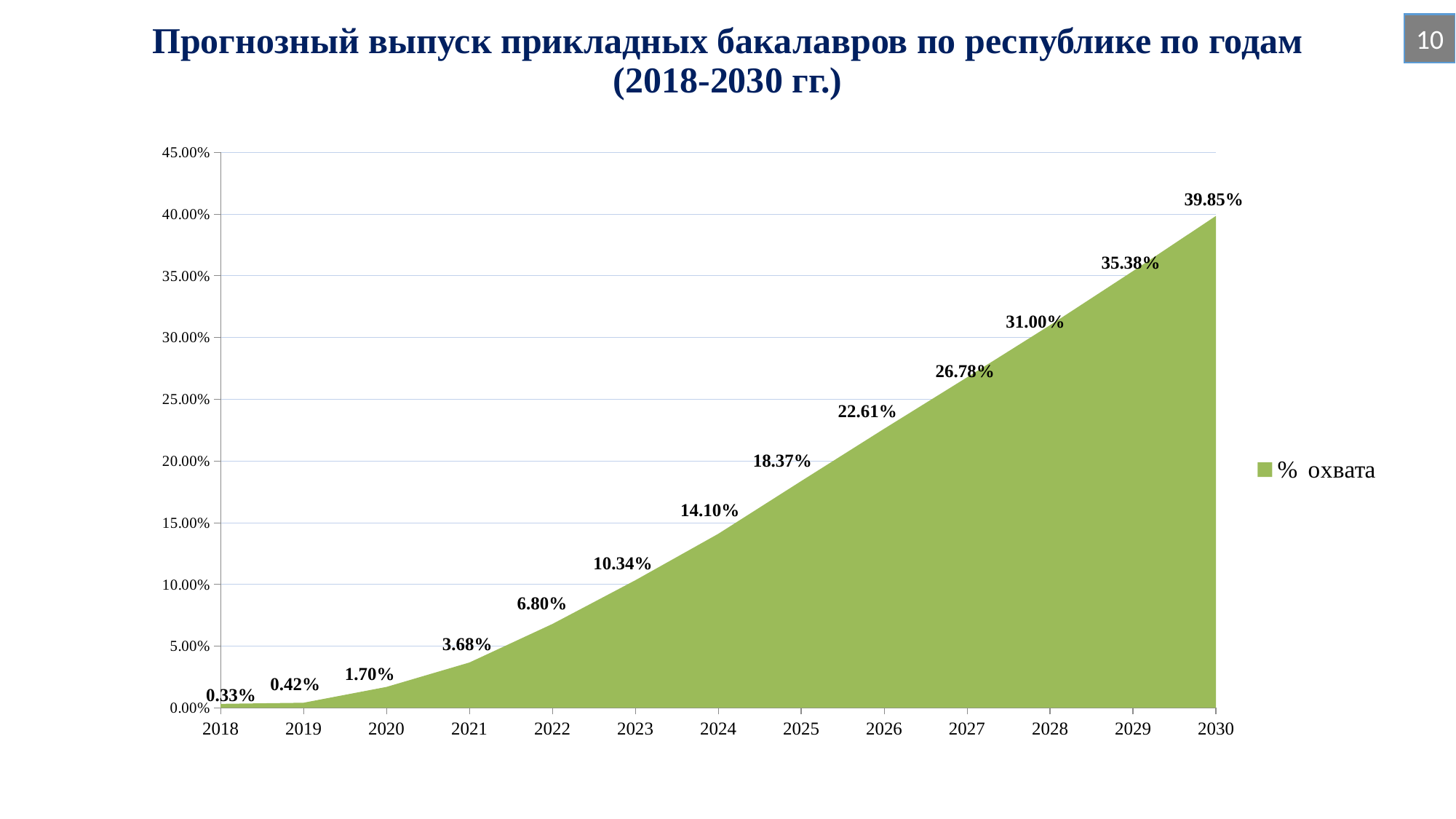
Which is larger, the value for 2023 or the value for 2025? 2025 Which year has the lowest value? 2018 What is the value for 2028? 31.00% What is the difference between the values for 2030 and 2029? 4.47% Is the value for 2027 greater or less than 25.00%? greater Do the values rise or fall from 2018 to 2030? rise Which year has the highest value? 2030 What is the value for 2021? 3.68% What is the value for 2024? 14.10% What kind of chart is this? area chart How many series does the legend list? 1 How many years are shown on the x axis? 13